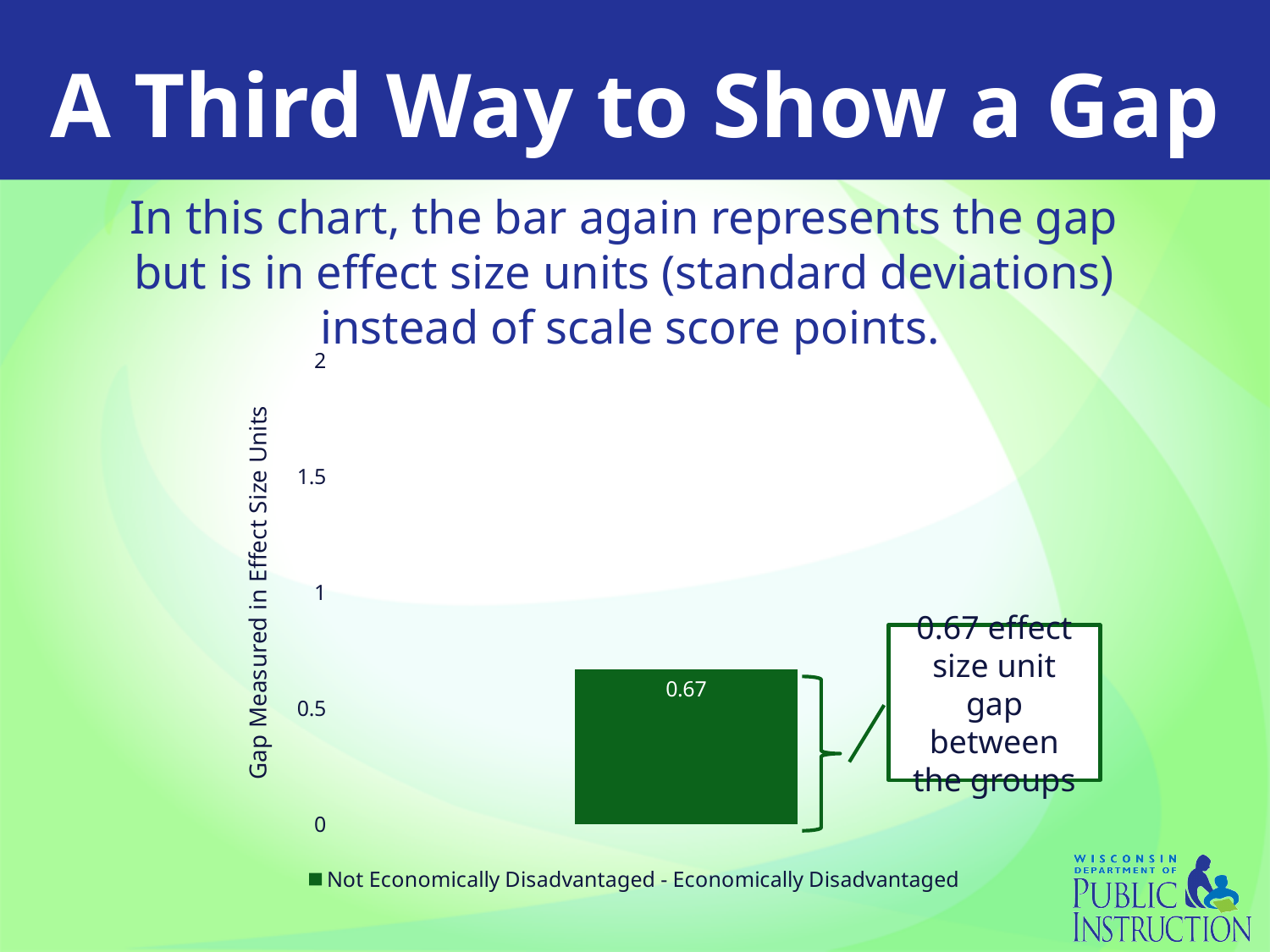
What kind of chart is shown on the slide? bar chart What is the value of the bar labelled 'Not Economically Disadvantaged - Economically Disadvantaged'? 0.67 Is the value of the bar greater or less than 1? less What is the highest value shown on the y axis? 2 How many bars are plotted in the chart? 1 What is the legend entry for the plotted series? Not Economically Disadvantaged - Economically Disadvantaged Is the value of the bar greater or less than 0.5? greater What is the label of the y axis? Gap Measured in Effect Size Units How many series does the legend list? 1